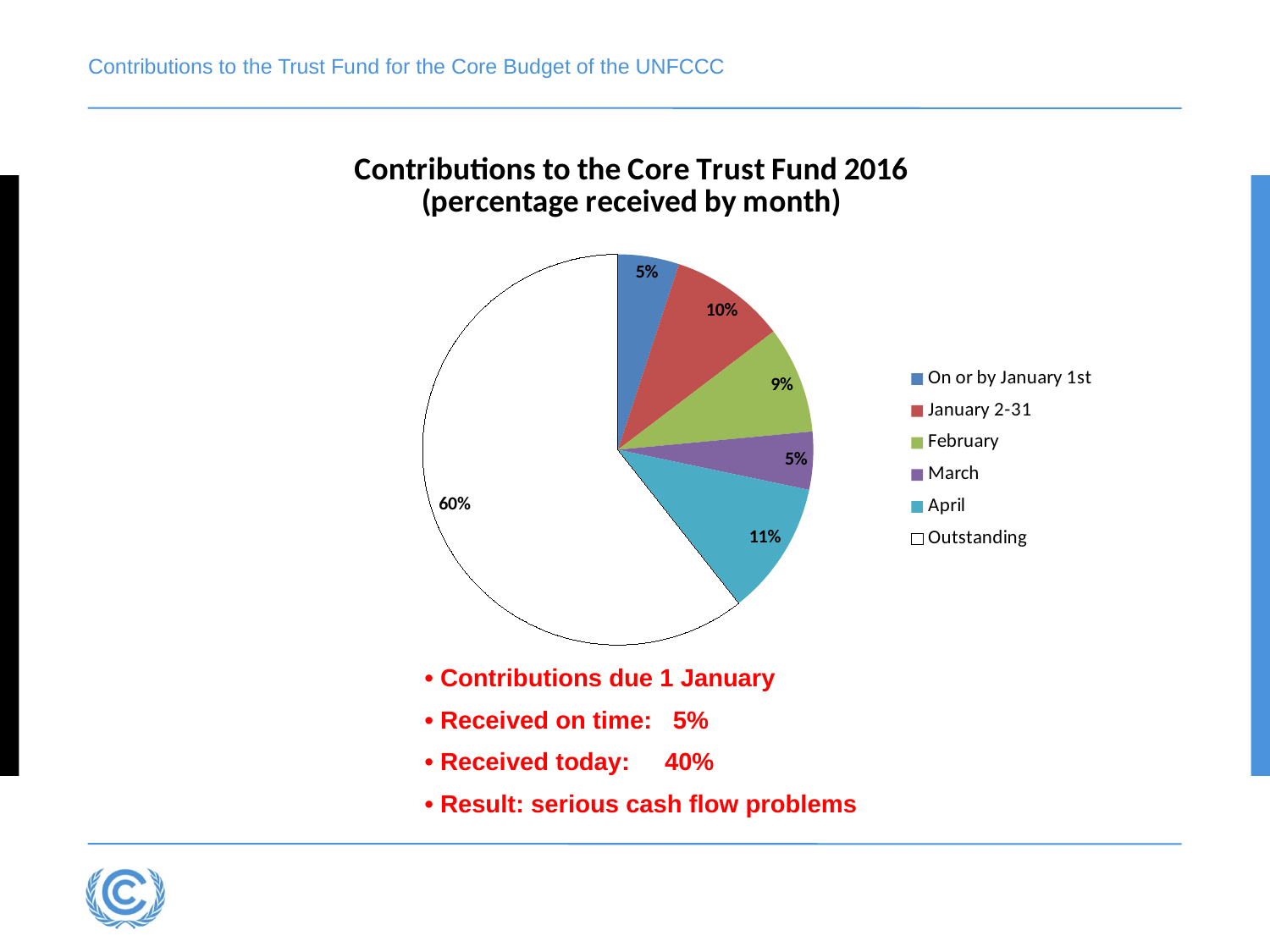
What percentage of contributions was received during January 2-31? 10% Which category has the largest slice of the pie? Outstanding What is the difference in percentage points between the Outstanding slice and the April slice? 49 Which is larger: the share received in January 2-31 or the share received in February? January 2-31 What percentage of contributions was received in March? 5% What share of the pie is Outstanding? 60% What percentage of contributions was received in February? 9% What kind of chart is shown on the slide? pie chart What percentage of contributions was received in April? 11% How many categories does the legend list? 6 What is the title of the chart? Contributions to the Core Trust Fund 2016 (percentage received by month) What percentage of contributions was received on or by January 1st? 5%